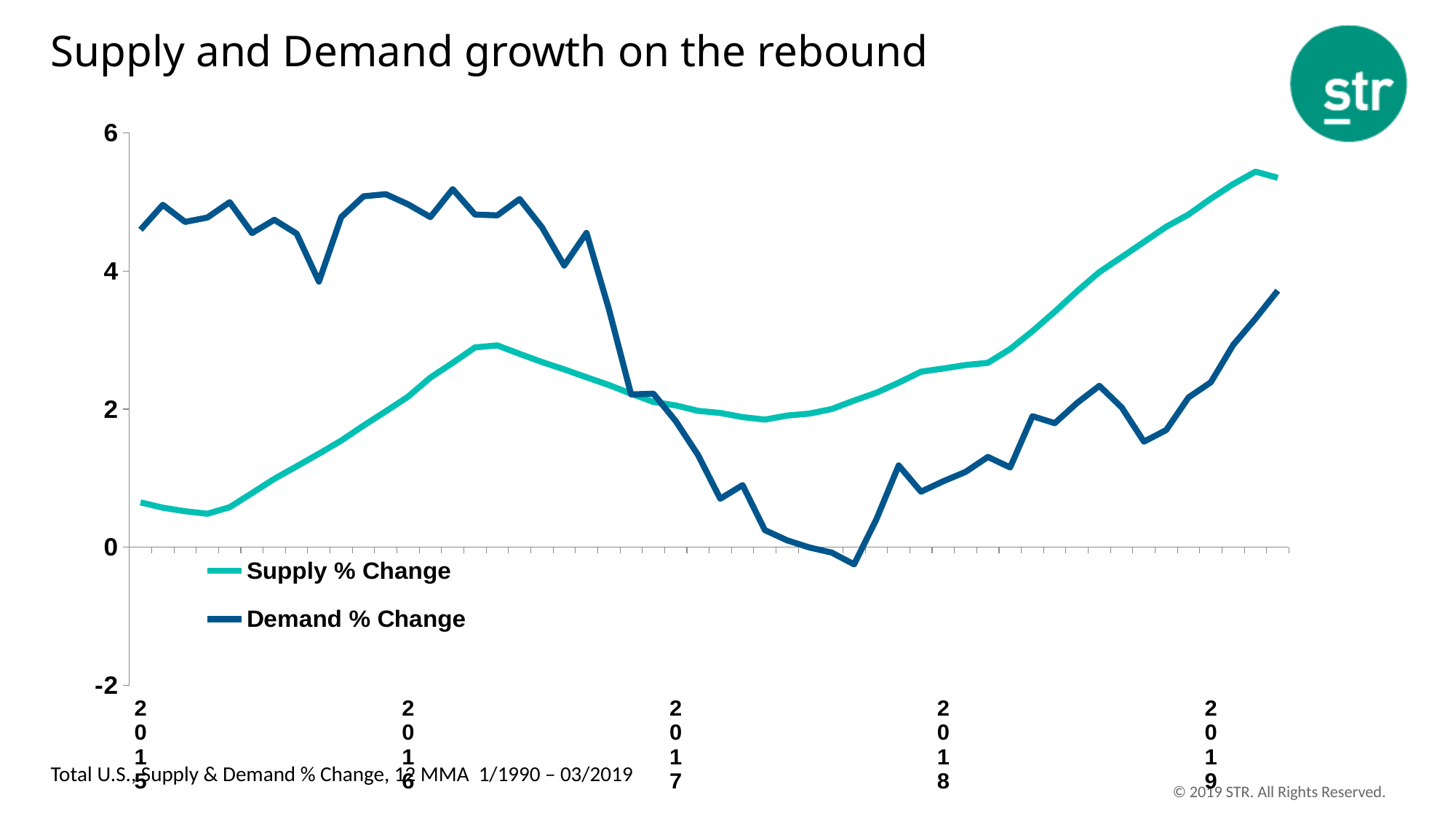
Does the Demand % Change line rise or fall between 2016 and 2017? fall What is the title of the slide? Supply and Demand growth on the rebound Which series drops below 0 at some point on the chart? Demand % Change What are the two series named in the legend? Supply % Change and Demand % Change At the start of 2015, which series has the higher value, Supply % Change or Demand % Change? Demand % Change What kind of chart is shown on the slide? line chart How many series does the legend list? 2 At the start of 2018, which series has the higher value, Supply % Change or Demand % Change? Supply % Change At the start of 2015, is the value for Demand % Change greater or less than 4? greater How many year labels are shown on the x axis? 5 At the start of 2015, is the value for Supply % Change greater or less than 2? less Does the Supply % Change line rise or fall between 2017 and 2019? rise